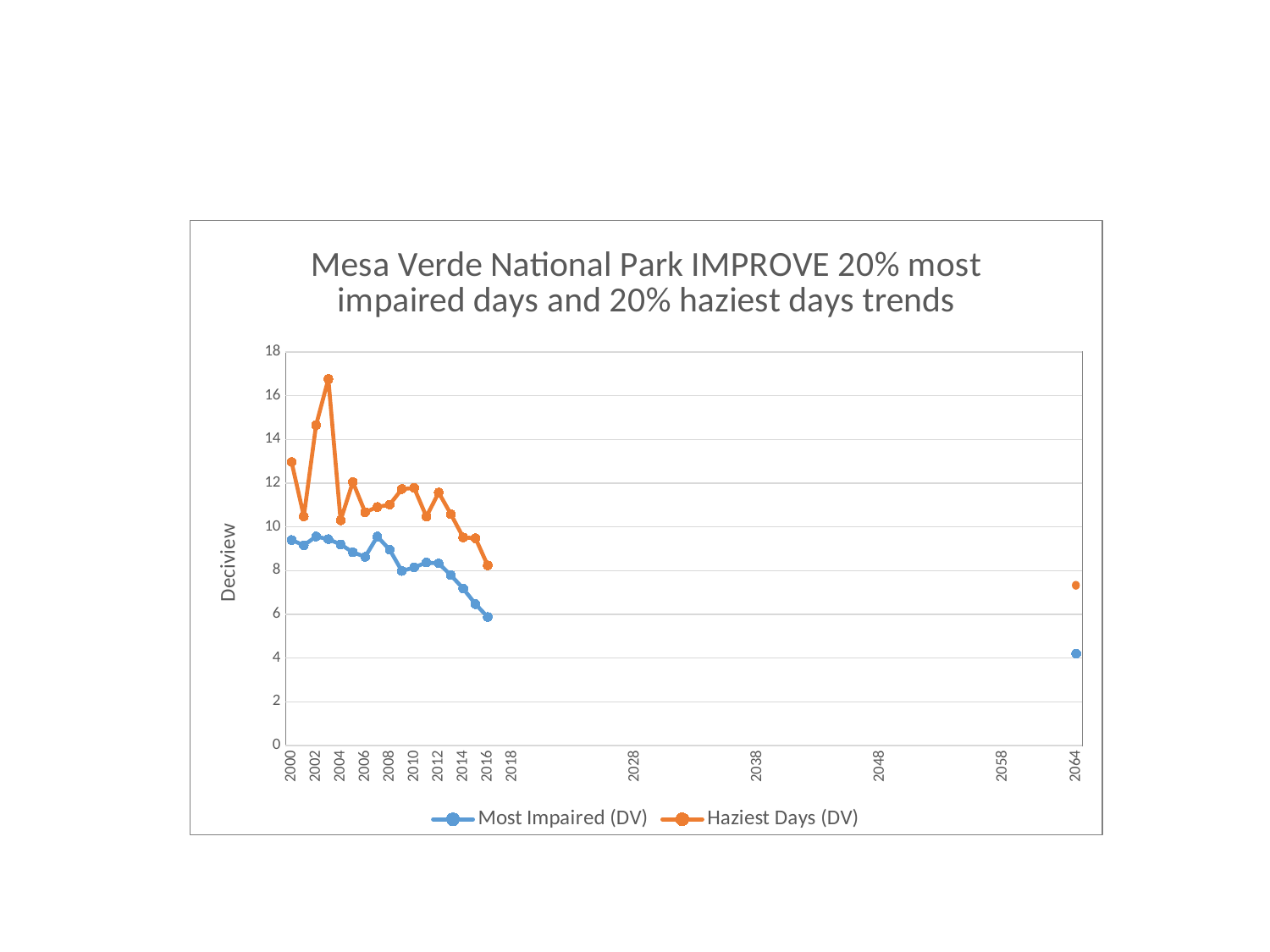
What are the two series named in the legend? Most Impaired (DV) and Haziest Days (DV) What type of chart is shown on the slide? line chart In which year does the Haziest Days (DV) series reach its highest value? 2003 Is the Most Impaired (DV) value for 2064 greater or less than 6? less Does the Most Impaired (DV) series rise or fall between 2007 and 2016? fall Is the Haziest Days (DV) value for 2064 greater or less than 8? less What is the label on the vertical axis of the chart? Deciview How many series does the legend list? 2 In which year does the Most Impaired (DV) series have its lowest value? 2064 In 2000, which series has the higher value, Most Impaired (DV) or Haziest Days (DV)? Haziest Days (DV) Is the Most Impaired (DV) value for 2000 greater or less than 8? greater